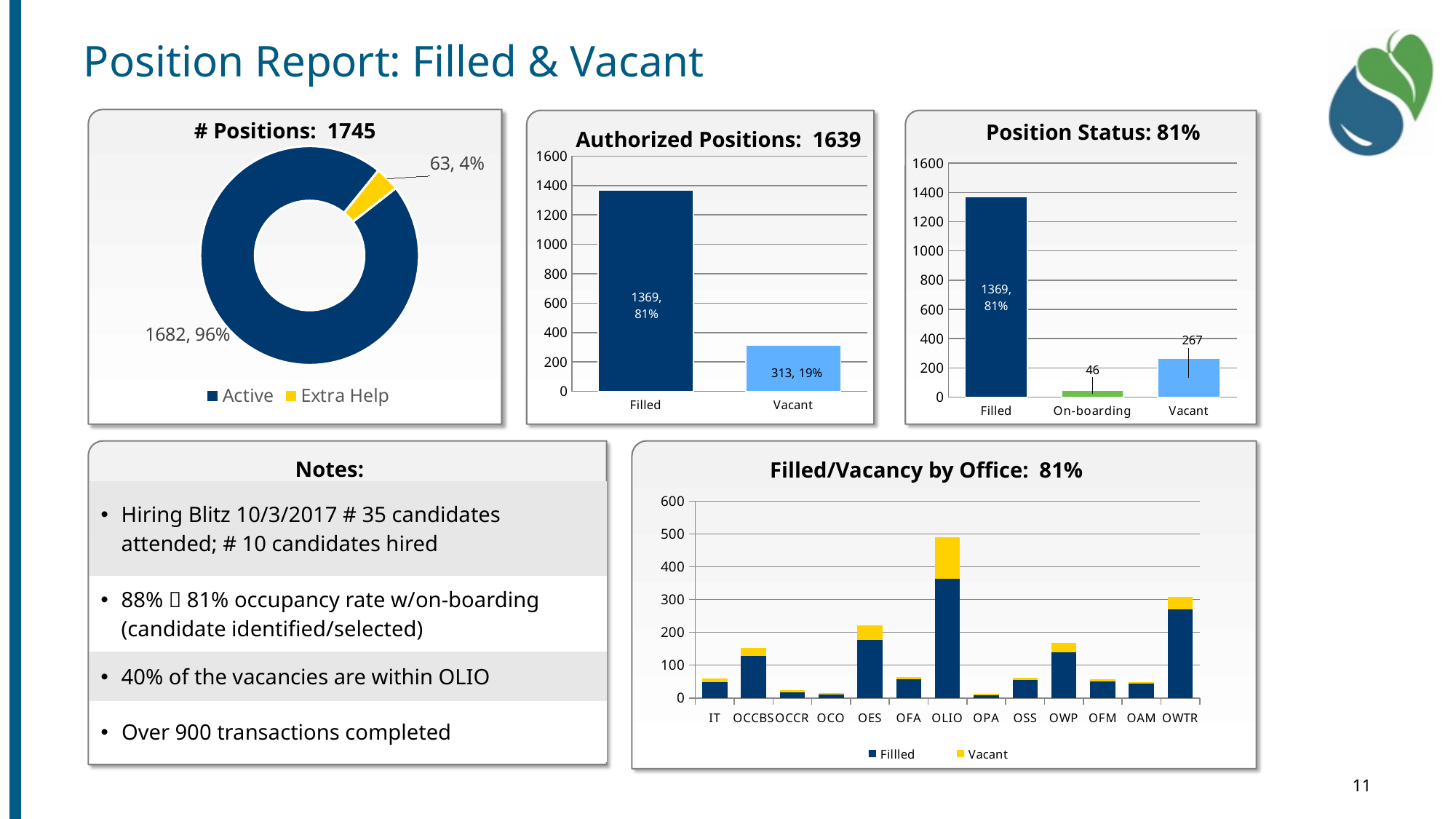
What kind of chart is the '# Positions: 1745' chart? Donut chart In the 'Filled/Vacancy by Office: 81%' chart, is the total for OWTR greater or less than 200? greater In the 'Authorized Positions: 1639' chart, what is the value for Vacant? 313, 19% How many series does the legend of the 'Filled/Vacancy by Office: 81%' chart list? 2 In the '# Positions: 1745' chart, what share of the donut is Active? 96% In the 'Filled/Vacancy by Office: 81%' chart, which office has the tallest stacked bar? OLIO In the '# Positions: 1745' chart, what value is shown for Extra Help? 63, 4% In the 'Position Status: 81%' chart, what is the difference between Vacant and On-boarding? 221 In the 'Position Status: 81%' chart, which category has the lowest value? On-boarding In the 'Position Status: 81%' chart, what is the value for On-boarding? 46 In the 'Authorized Positions: 1639' chart, what is the difference between Filled and Vacant? 1056 In the 'Filled/Vacancy by Office: 81%' chart, how many offices are shown on the x axis? 13